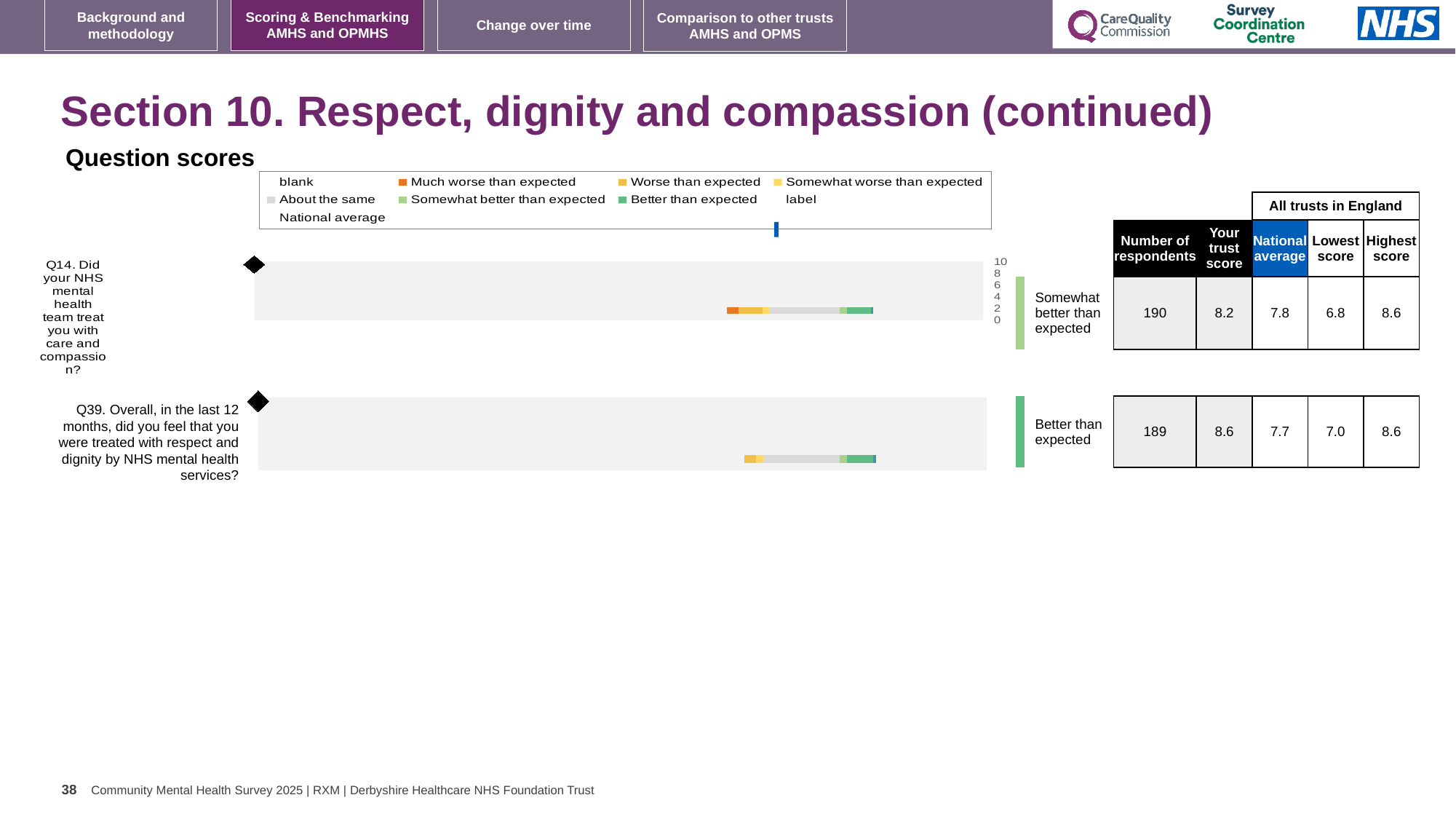
What is the national average score for Q14 (treated with care and compassion)? 7.8 Which question has the higher trust score, Q14 or Q39? Q39 What is the difference between the trust score and the national average for Q39? 0.9 What kind of chart is used to show the question scores? Bar chart What is the trust score for Q39 (treated with respect and dignity)? 8.6 What is the difference between the trust score and the national average for Q14? 0.4 How many respondents answered Q14 according to the table? 190 What is the lowest score among all trusts in England for Q39? 7.0 Which question has more respondents, Q14 or Q39? Q14 How many questions are plotted in the chart? 2 What is the highest score among all trusts in England for Q14? 8.6 What benchmark category is shown next to the bar for Q14? Somewhat better than expected